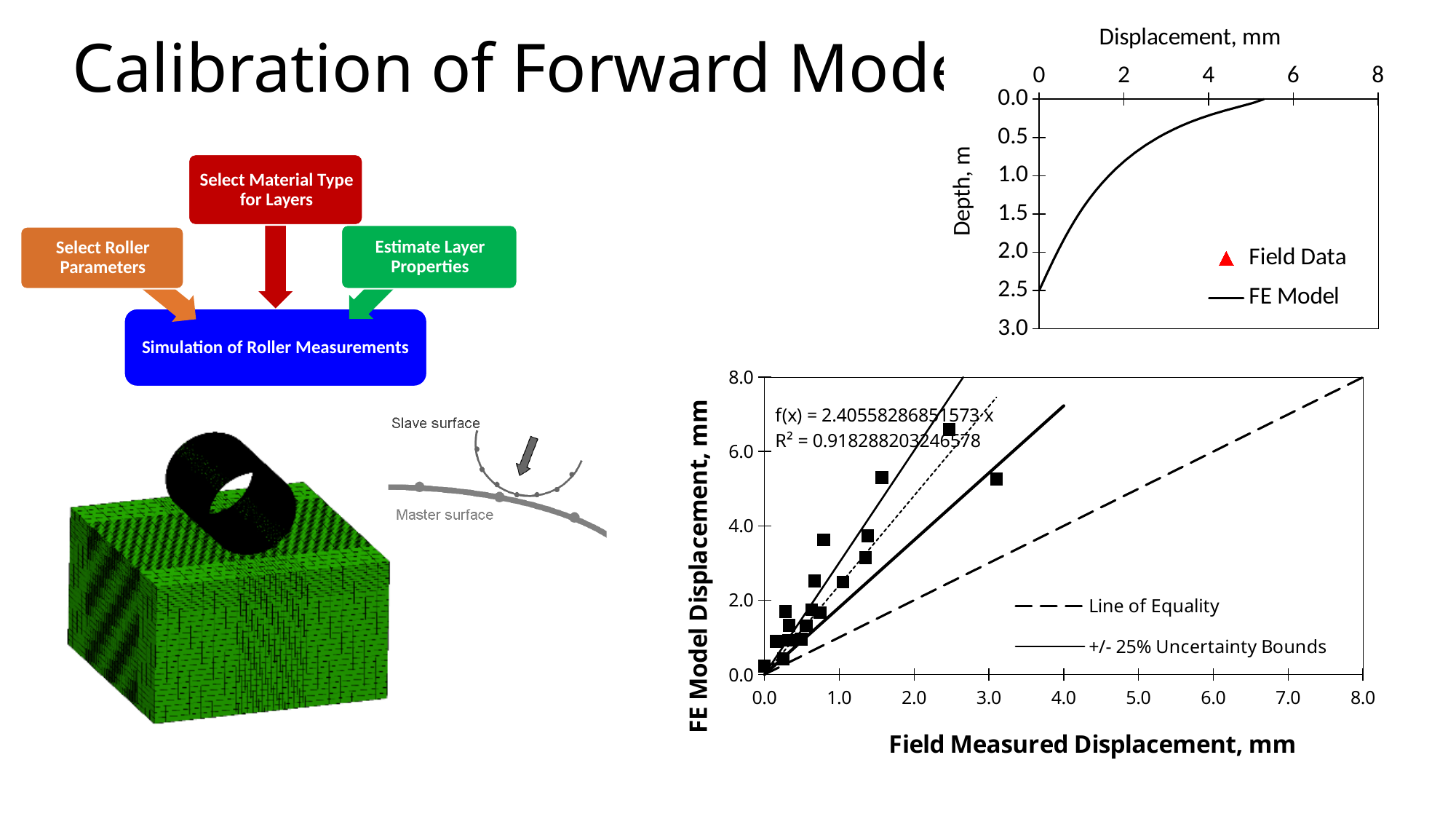
In the bottom-right chart, what is the R² value shown for the fitted line? 0.918288203246578 In the top-right chart, what is the title of the horizontal axis? Displacement, mm What kind of chart is the bottom-right chart plotting FE Model Displacement against Field Measured Displacement? scatter chart How many series does the legend of the top-right chart list? 2 In the bottom-right chart, what is the equation of the fitted line shown on the chart? f(x) = 2.405582868851573·x In the bottom-right chart, what is the maximum value shown on the Field Measured Displacement axis? 8.0 In the top-right chart, what is the title of the vertical axis? Depth, m In the top-right chart, is the FE Model displacement at a depth of 0.0 m greater or less than 4 mm? greater In the bottom-right chart, do the FE Model Displacement values generally rise or fall as Field Measured Displacement increases? rise In the top-right chart, does the FE Model displacement increase or decrease as depth increases from 0.0 m to 2.5 m? decrease What kind of chart is the top-right chart with the Depth axis? line chart In the top-right chart, is the FE Model displacement at a depth of 2.0 m greater or less than 2 mm? less